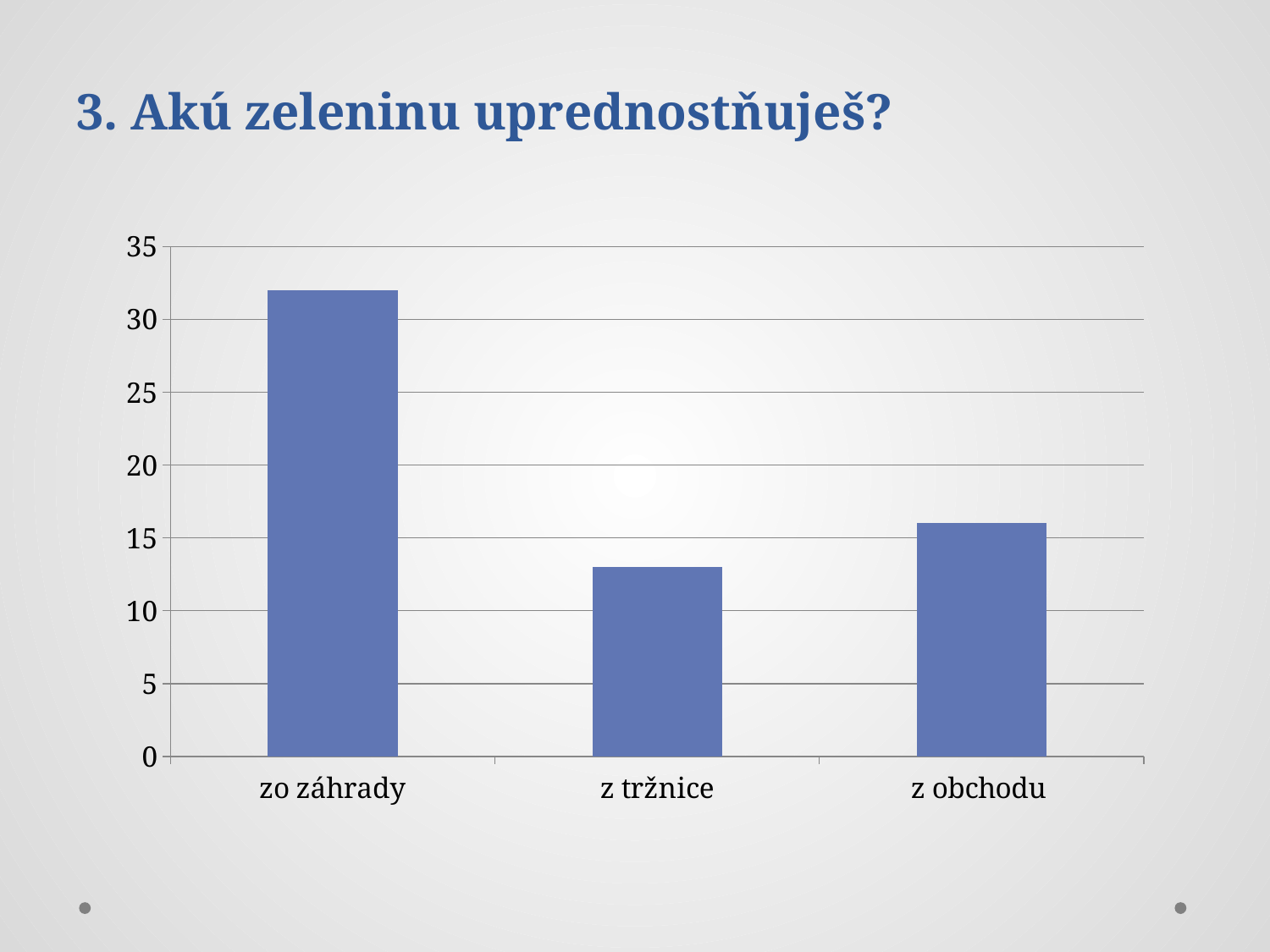
How many categories are shown on the x axis of the chart? 3 What is the title of the slide containing the chart? 3. Akú zeleninu uprednostňuješ? Is the value for z obchodu greater or less than 20? less Which category has the lowest value in the chart? z tržnice Which category has the highest value in the chart? zo záhrady Which is larger, the value for z tržnice or the value for z obchodu? z obchodu Which is larger, the value for zo záhrady or the value for z obchodu? zo záhrady What kind of chart is shown on the slide? bar chart What is the highest value shown on the vertical axis of the chart? 35 Is the value for z obchodu greater or less than 15? greater Is the value for zo záhrady greater or less than 30? greater